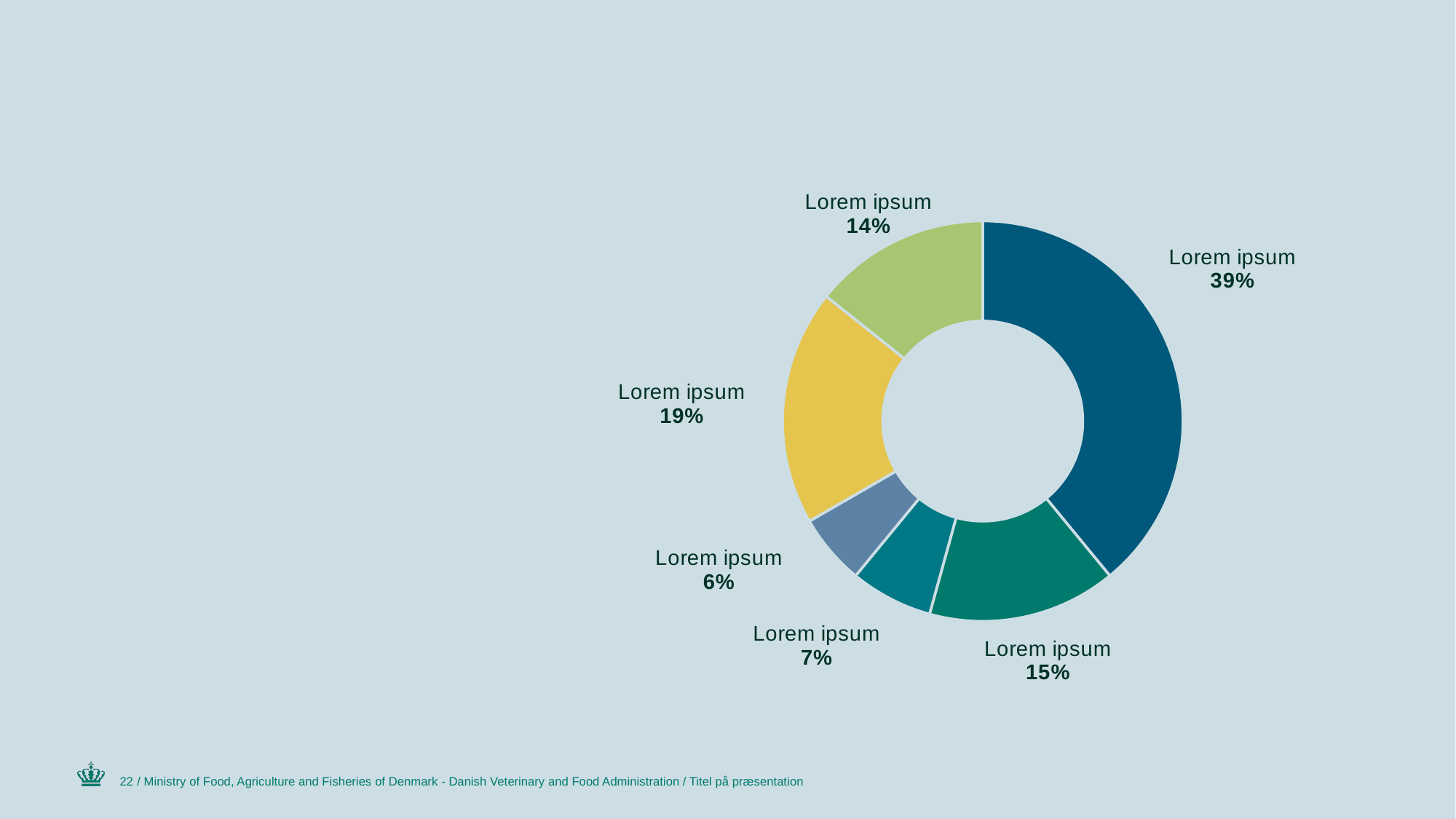
What kind of chart is shown on the slide? pie chart (donut) What text label is shown for every slice of the pie chart? Lorem ipsum What is the difference in percentage points between the largest slice (39%) and the green slice labelled 15%? 24 percentage points What percentage is shown for the dark blue slice of the pie chart? 39% Which slice is larger, the yellow slice or the light green slice? the yellow slice (19%) How many slices does the pie chart have? 6 What is the smallest percentage shown on the pie chart? 6% What do all the slice percentages on the pie chart add up to? 100% What percentage is shown for the light green slice of the pie chart? 14% What is the largest percentage shown on the pie chart? 39% What percentage is shown for the yellow slice of the pie chart? 19% What is the difference in percentage points between the yellow slice and the light green slice? 5 percentage points